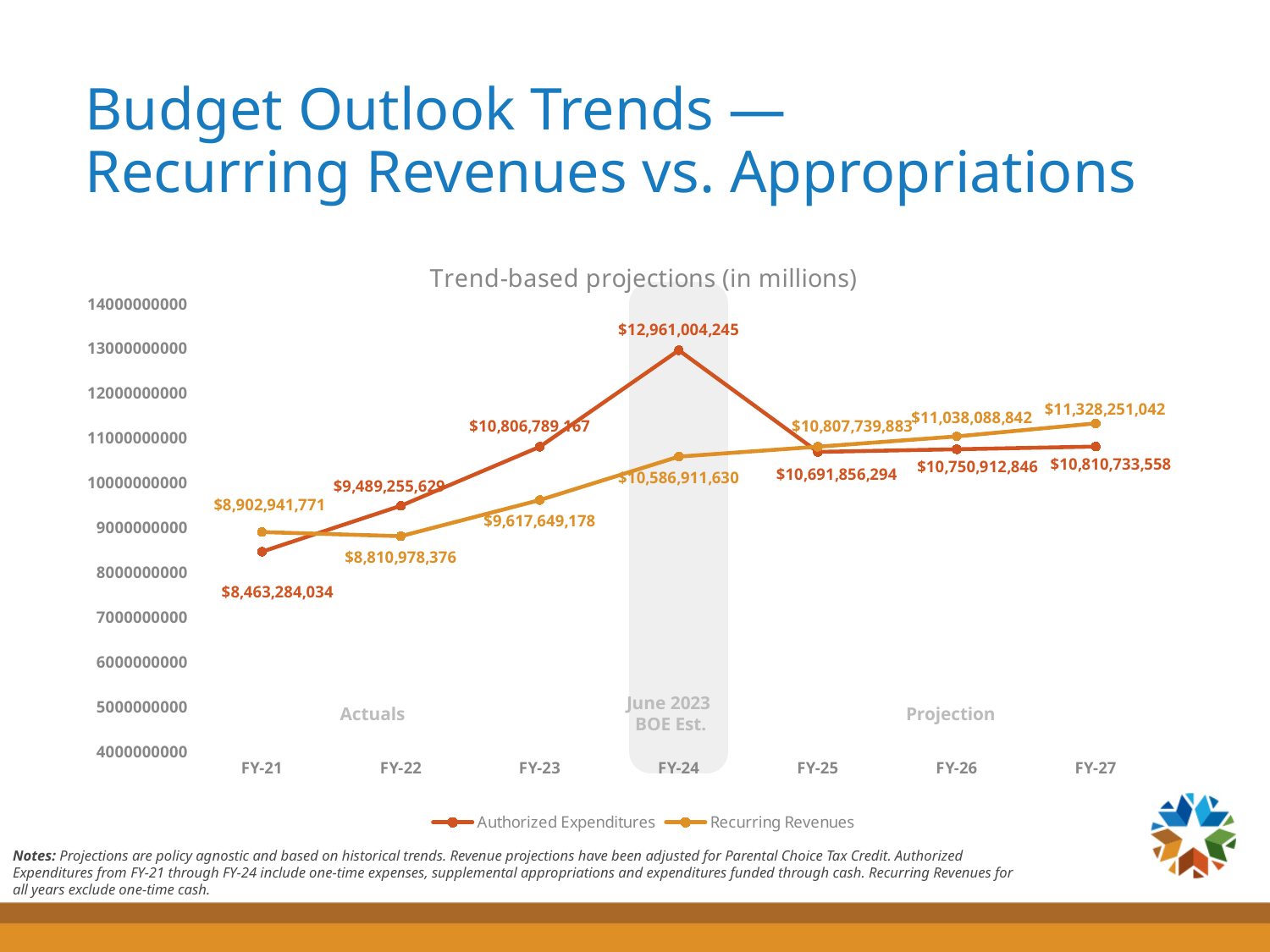
In which fiscal year are Authorized Expenditures highest? FY-24 By how much do Authorized Expenditures exceed Recurring Revenues in FY-24? $2,374,092,615 What is the Recurring Revenues value for FY-21? $8,902,941,771 What kind of chart is shown on the slide? line chart What is the Authorized Expenditures value for FY-24? $12,961,004,245 What is the difference between Recurring Revenues and Authorized Expenditures in FY-27? $517,517,484 How many series does the legend list? 2 In FY-25, which is larger: Authorized Expenditures or Recurring Revenues? Recurring Revenues In which fiscal year are Recurring Revenues lowest? FY-22 What is the Recurring Revenues value for FY-27? $11,328,251,042 How many fiscal years are shown on the x axis? 7 Is the Authorized Expenditures value for FY-21 greater or less than 9000000000? less